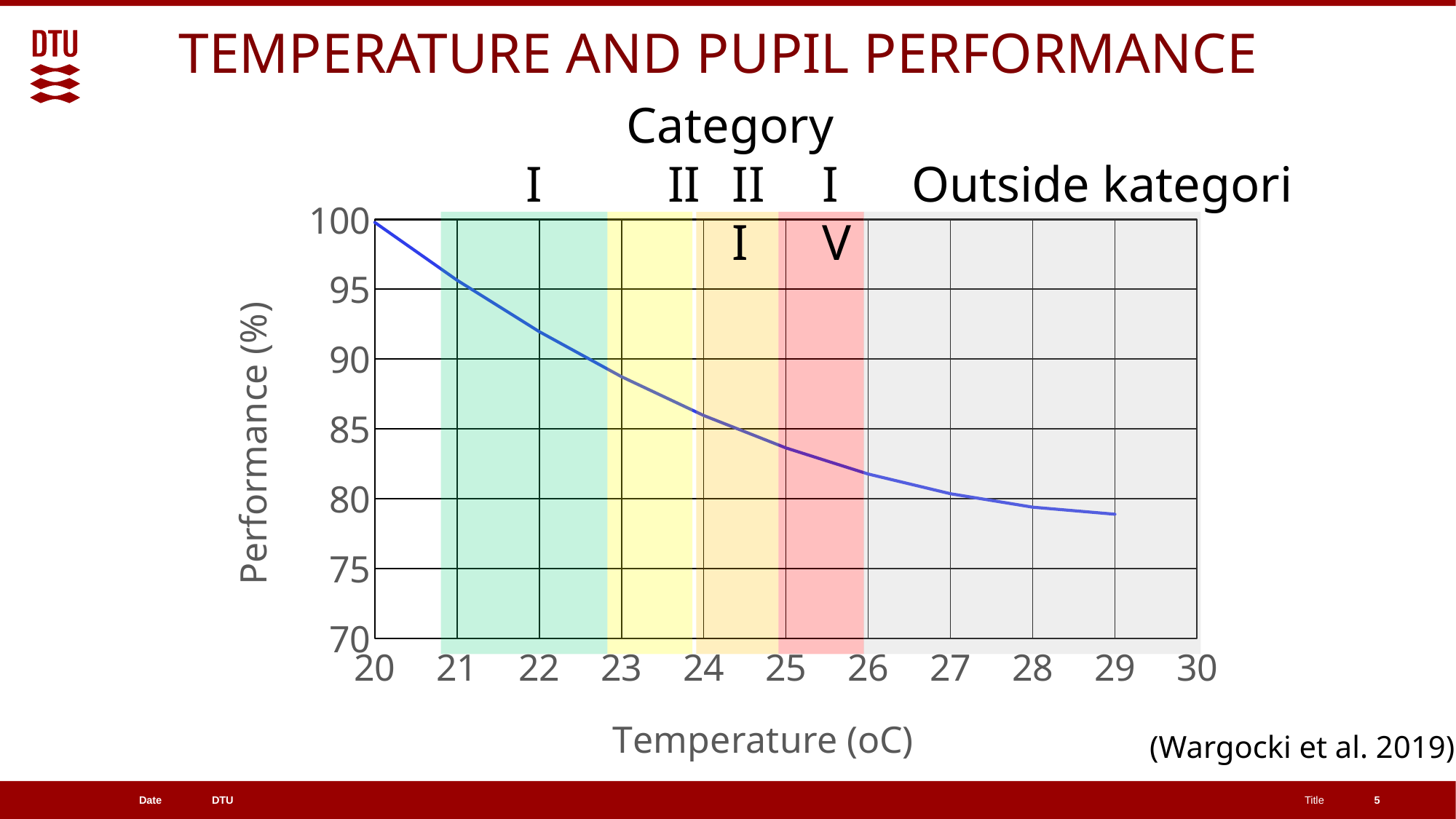
Is the performance at 23 oC greater or less than 90? less Is the performance at 22 oC greater or less than 90? greater How many lines are plotted on the chart? 1 Does performance rise or fall as temperature increases along the x axis? fall What kind of chart is shown on the slide? line chart Is the performance at 26 oC greater or less than 85? less What is the label of the x axis? Temperature (oC) At which temperature on the x axis is performance highest? 20 What is the label of the y axis? Performance (%) Which has the higher performance, 22 oC or 26 oC? 22 oC